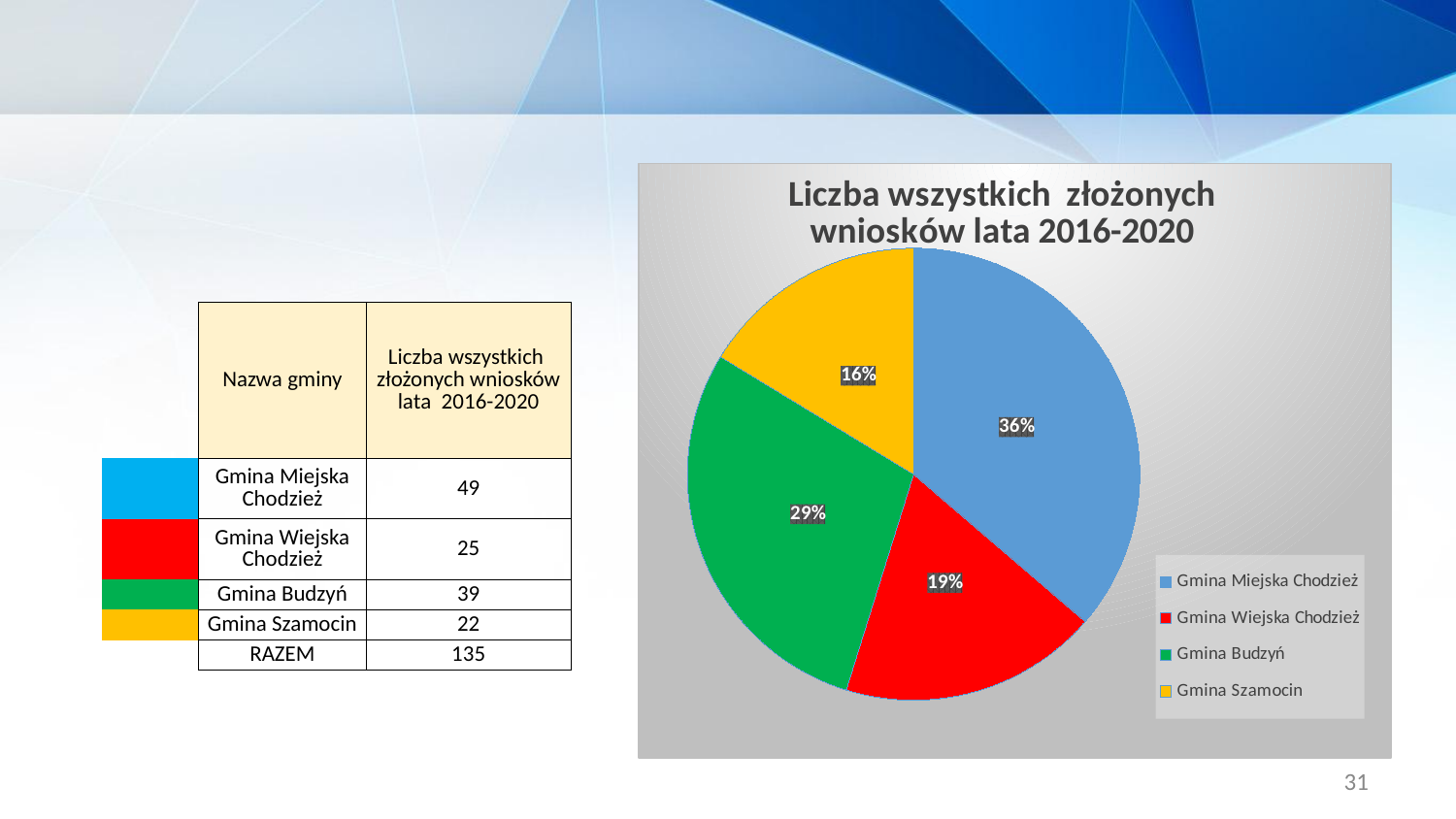
What share of the pie does Gmina Wiejska Chodzież have? 19% What is the title of the pie chart? Liczba wszystkich złożonych wniosków lata 2016-2020 What share of the pie does Gmina Budzyń have? 29% Which has a larger share of the pie, Gmina Budzyń or Gmina Wiejska Chodzież? Gmina Budzyń What type of chart is shown on the slide? pie chart What colour is the slice for Gmina Budzyń in the pie chart? green Which gmina has the largest slice of the pie? Gmina Miejska Chodzież How many slices does the pie chart have? 4 What is the difference in percentage points between the shares of Gmina Miejska Chodzież and Gmina Szamocin? 20 percentage points What share of the pie does Gmina Szamocin have? 16% Which gmina has the smallest slice of the pie? Gmina Szamocin